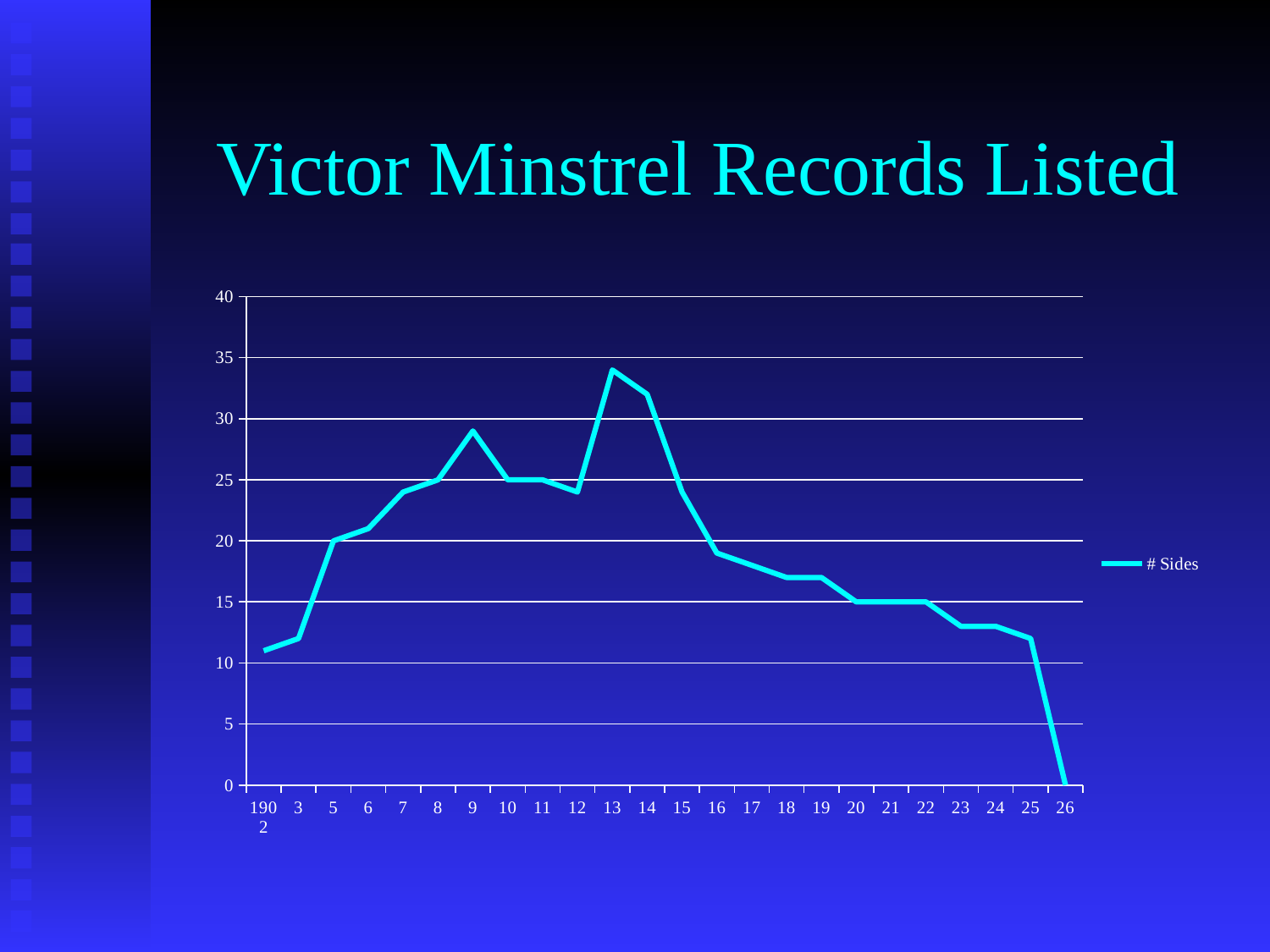
What is the name of the series shown in the legend? # Sides What is the title of the chart? Victor Minstrel Records Listed What is the value for 26? 0 Is the value for 13 greater or less than 30? greater How many points are plotted along the x axis? 24 Which year has the highest number of sides? 13 How many series does the legend list? 1 Which year has the lowest number of sides? 26 Is the value for 18 greater or less than 20? less What kind of chart is shown on the slide? line chart Do the values rise or fall from 13 to 26? fall Which is larger, the value for 13 or the value for 9? 13